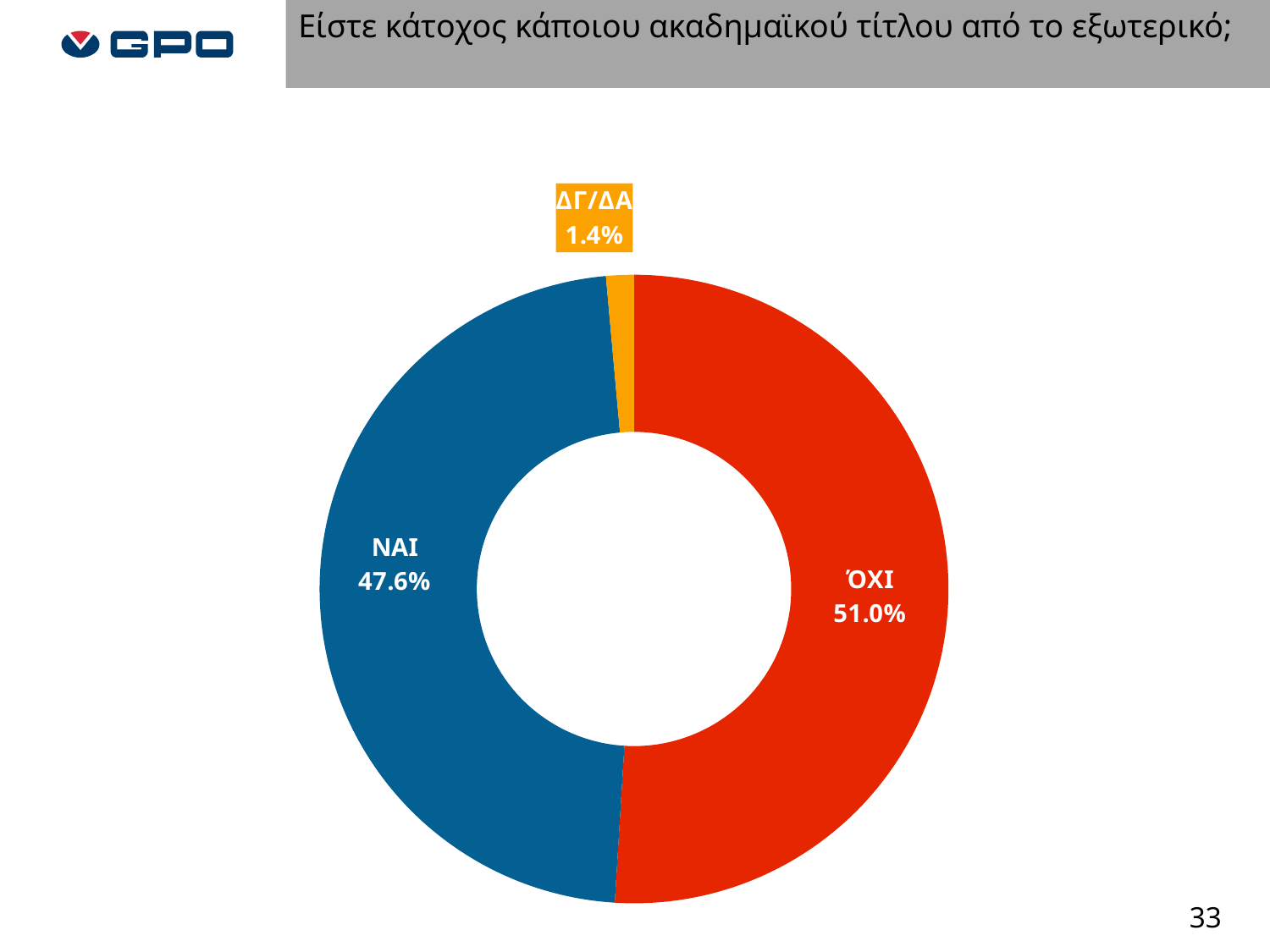
What is the question shown as the title of the slide? Είστε κάτοχος κάποιου ακαδημαϊκού τίτλου από το εξωτερικό; Which response has the smallest share of the chart? ΔΓ/ΔΑ What type of chart is shown on the slide? Doughnut (pie) chart What percentage of respondents answered ΌΧΙ? 51.0% What colour is the ΝΑΙ segment of the chart? Blue What is the difference in percentage points between ΌΧΙ and ΝΑΙ? 3.4 What is the difference in percentage points between ΝΑΙ and ΔΓ/ΔΑ? 46.2 What is the value shown for ΔΓ/ΔΑ? 1.4% Which is larger, the share for ΝΑΙ or the share for ΌΧΙ? ΌΧΙ What percentage of respondents answered ΝΑΙ? 47.6% How many categories are shown in the chart? 3 Which response has the largest share of the chart? ΌΧΙ